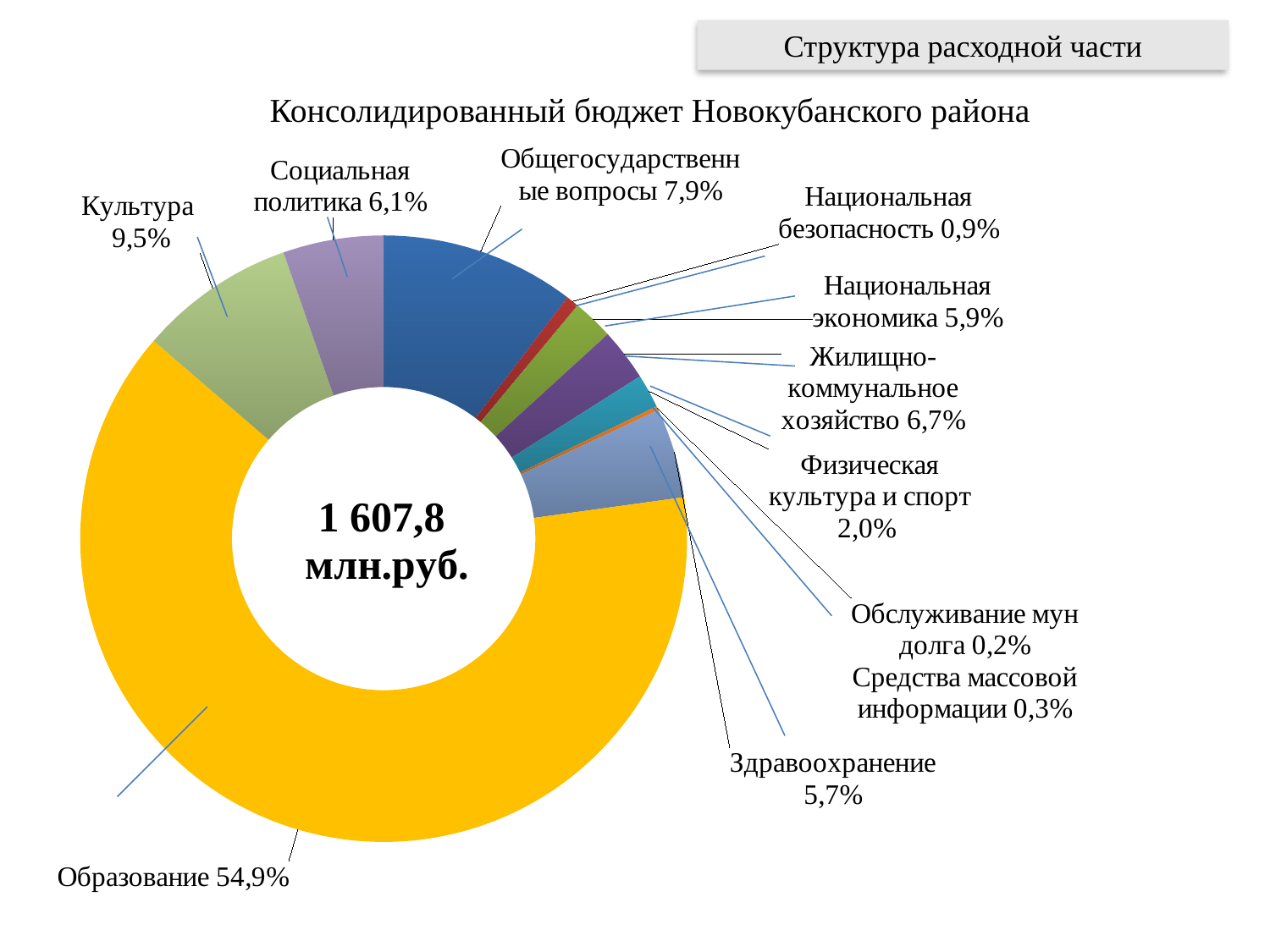
Which category has the smallest share of the chart? Обслуживание мун долга What share of the budget goes to Образование? 54,9% Which category has the largest share of the chart? Образование What percentage is shown for Культура? 9,5% What total amount is printed in the centre of the chart? 1 607,8 млн.руб. What percentage is labelled for Здравоохранение? 5,7% What is the difference in percentage points between Культура and Социальная политика? 3,4 What type of chart is shown on the slide? Doughnut chart How many categories are shown in the chart? 11 Which is larger, the share for Общегосударственные вопросы or for Национальная экономика? Общегосударственные вопросы What is the title of the chart? Консолидированный бюджет Новокубанского района What is the share for Жилищно-коммунальное хозяйство? 6,7%